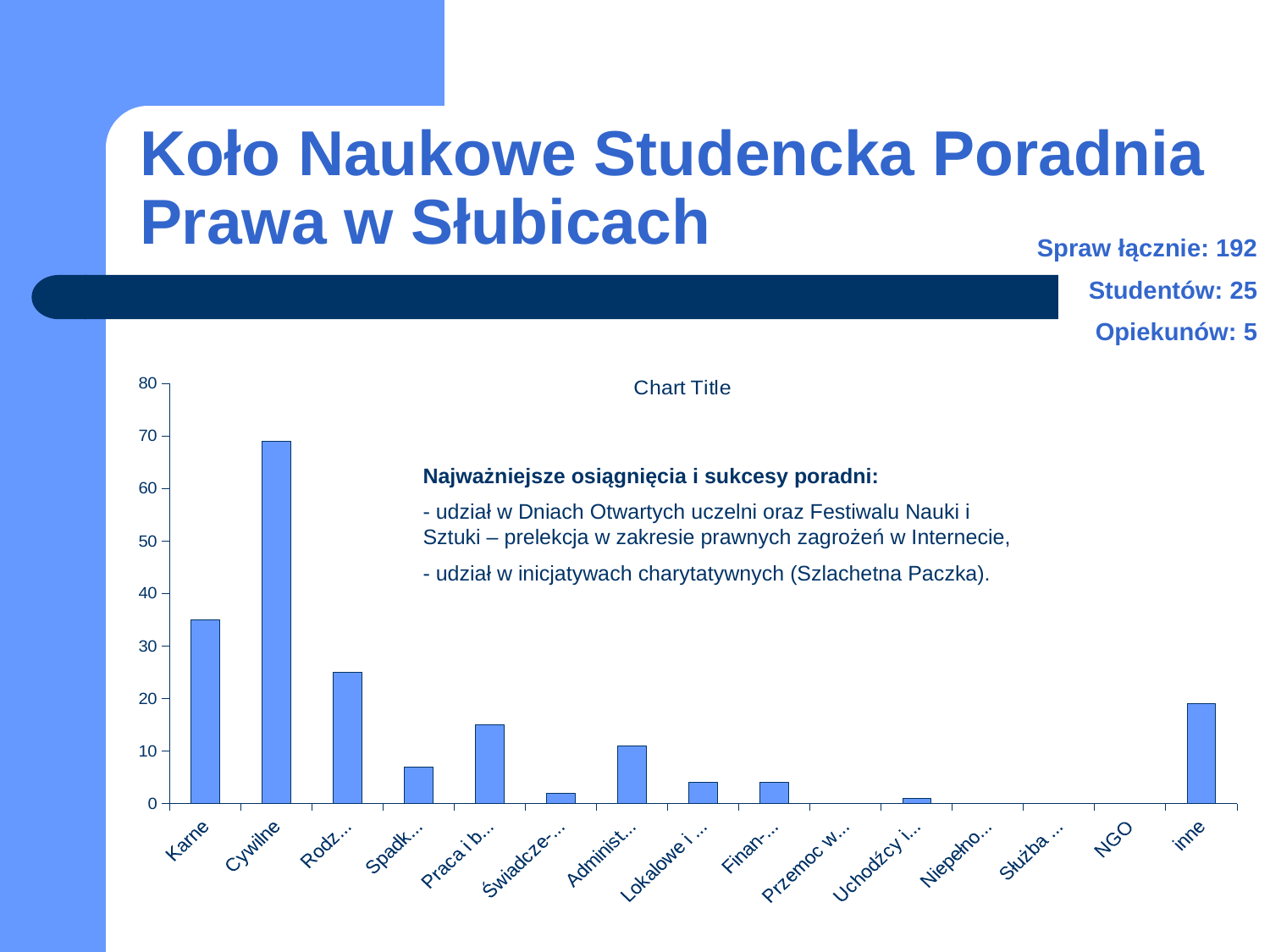
Which is larger, the value for Cywilne or the value for Karne? Cywilne Is the value for Cywilne greater or less than 60? greater Which category has the highest bar in the chart? Cywilne What is the title shown above the chart? Chart Title Is the value for Karne greater or less than 40? less Is the value for Karne greater or less than 30? greater What kind of chart is shown on the slide? bar chart How many categories are shown on the x axis of the chart? 15 Which is larger, the value for inne or the value for NGO? inne Which is larger, the value for Karne or the value for inne? Karne